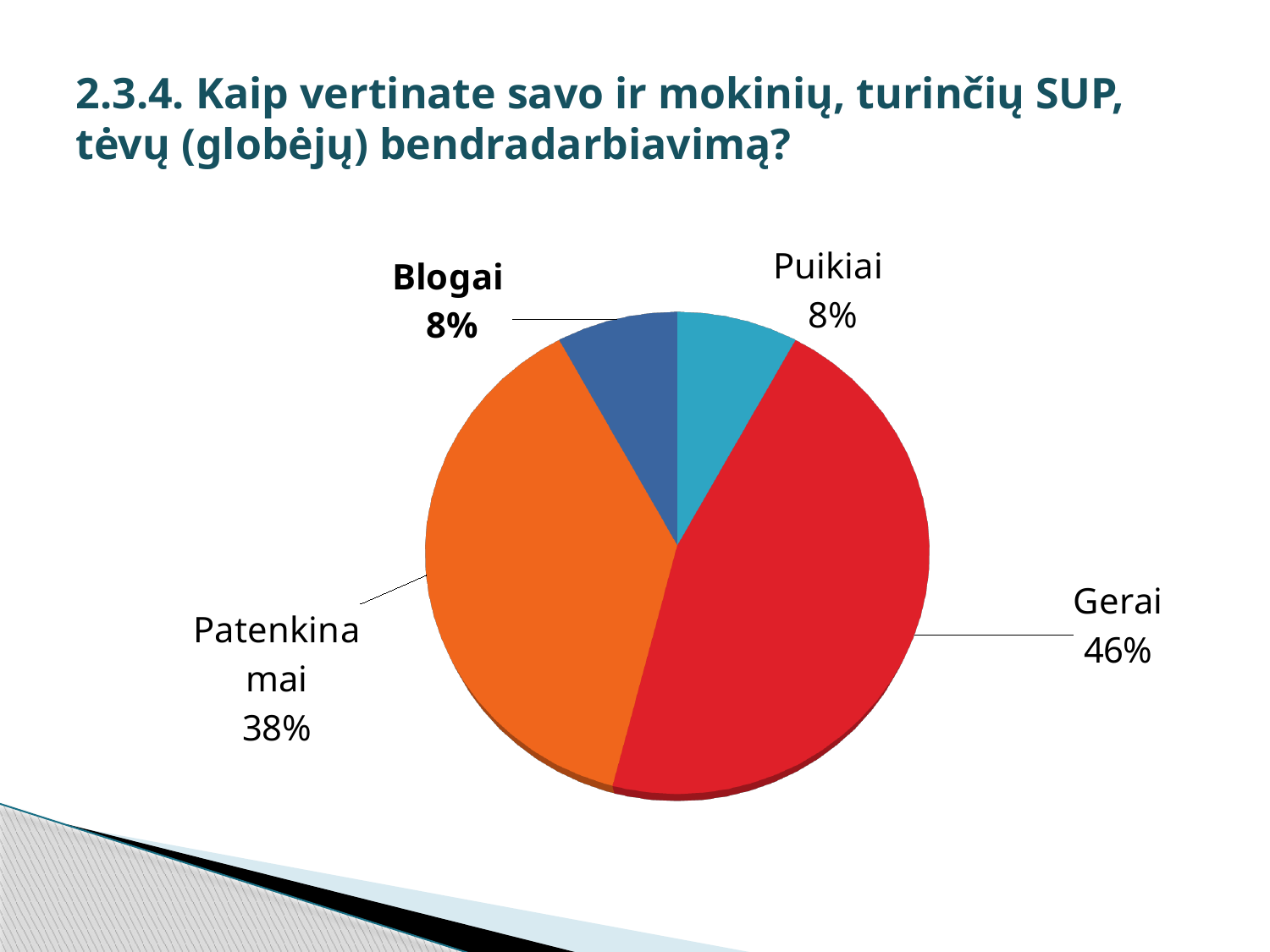
What share of the pie does the "Patenkinamai" slice represent? 38% What is the difference between the "Gerai" and "Patenkinamai" shares? 8% What share of the pie does the "Gerai" slice represent? 46% Which is larger, the "Patenkinamai" slice or the "Puikiai" slice? Patenkinamai What colour is the "Gerai" slice? red What is the value shown for "Blogai"? 8% How many slices does the pie chart have? 4 Which category has the largest slice of the pie? Gerai What kind of chart is shown on the slide? pie chart What is the value shown for "Puikiai"? 8% Which category label is shown in bold on the chart? Blogai What is the combined share of "Puikiai" and "Blogai"? 16%